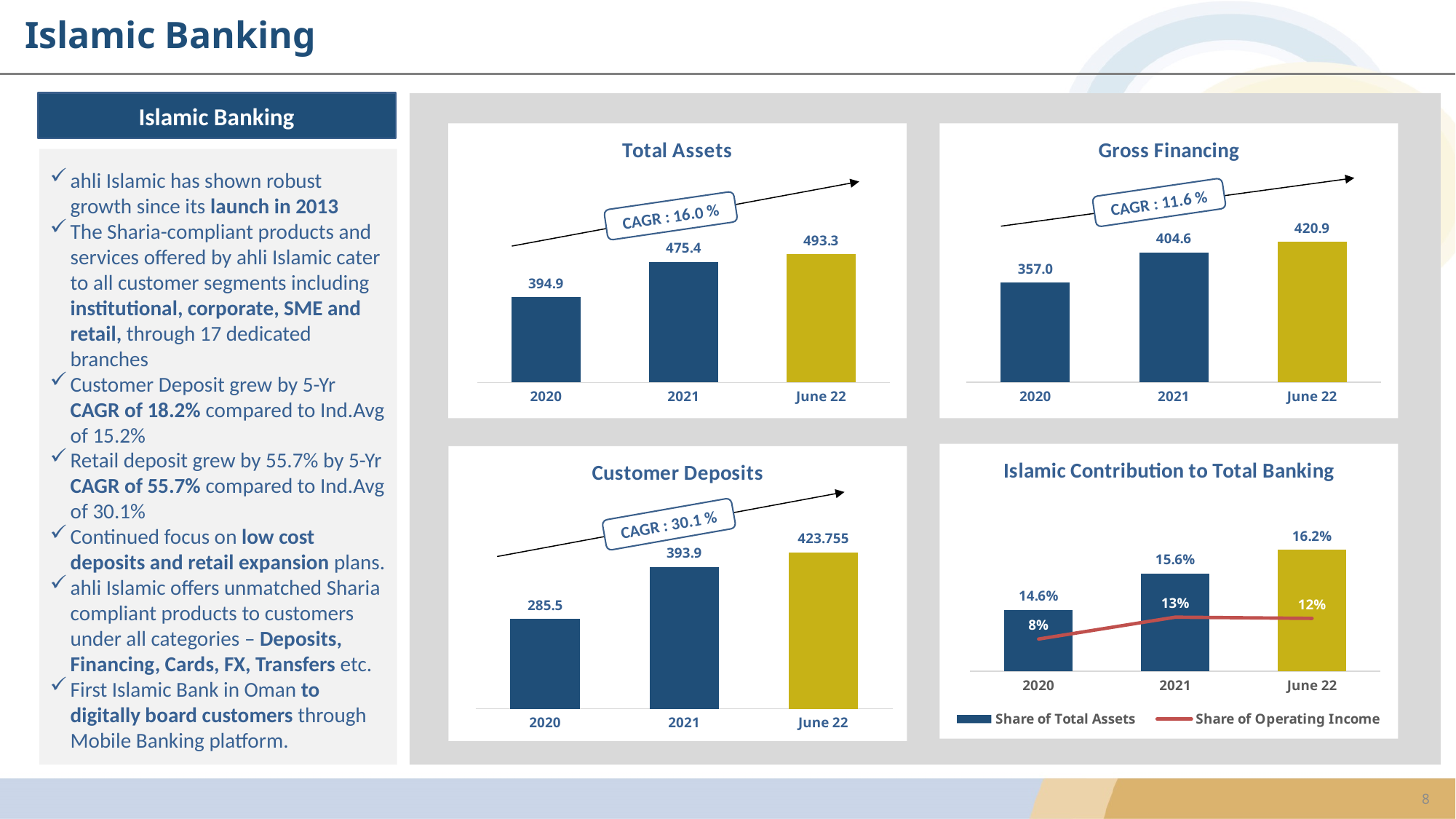
In the Islamic Contribution to Total Banking chart, what is the Share of Operating Income for 2020? 8% In the Total Assets chart, which year has the lowest value? 2020 What type of chart is the Total Assets chart? bar chart In the Customer Deposits chart, do the values rise or fall from 2020 to June 22? rise In the Total Assets chart, what is the value for 2021? 475.4 In the Customer Deposits chart, which period has the highest value? June 22 In the Gross Financing chart, what is the difference between the June 22 and 2020 values? 63.9 In the Islamic Contribution to Total Banking chart, how many series does the legend list? 2 In the Islamic Contribution to Total Banking chart, which is larger for June 22: Share of Total Assets or Share of Operating Income? Share of Total Assets In the Islamic Contribution to Total Banking chart, what is the Share of Total Assets for 2021? 15.6% In the Customer Deposits chart, what is the value for 2020? 285.5 In the Gross Financing chart, what is the value for June 22? 420.9